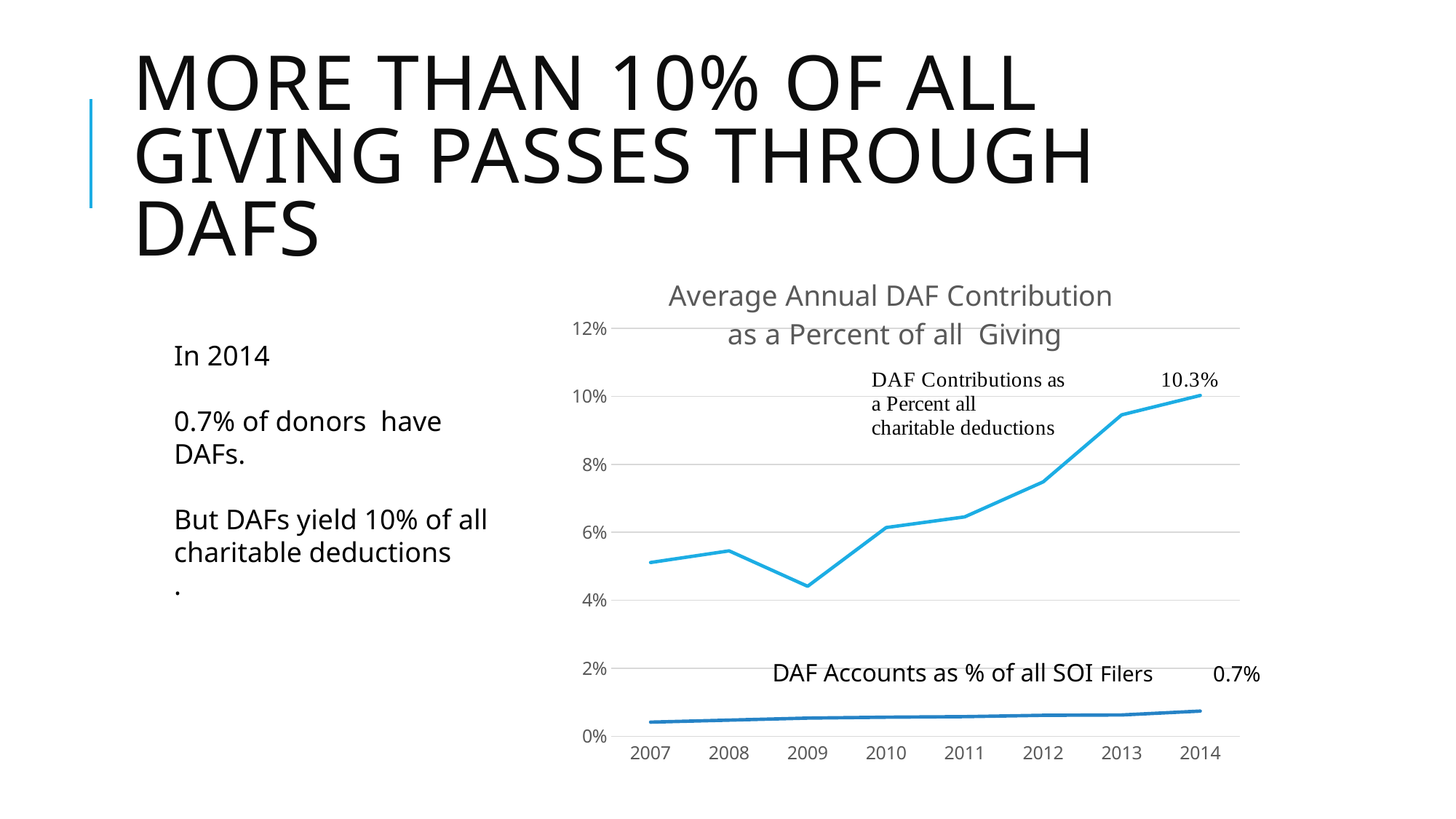
What is the title of the chart? Average Annual DAF Contribution as a Percent of all Giving Does the DAF Contributions line rise or fall from 2009 to 2014? Rises In which year is DAF Contributions as a Percent of all charitable deductions lowest? 2009 What is the value of DAF Accounts as % of all SOI Filers in 2014? 0.7% In which year is DAF Contributions as a Percent of all charitable deductions highest? 2014 Is the value of DAF Contributions as a Percent of all charitable deductions in 2013 greater or less than 8%? greater What type of chart is shown on the slide? Line chart Is the value of DAF Contributions as a Percent of all charitable deductions in 2009 greater or less than 6%? less What is the value of DAF Contributions as a Percent of all charitable deductions in 2014? 10.3% What is the difference between the 2014 values of the two lines (10.3% and 0.7%)? 9.6% How many years are shown on the x axis of the chart? 8 How many lines (series) are plotted on the chart? 2